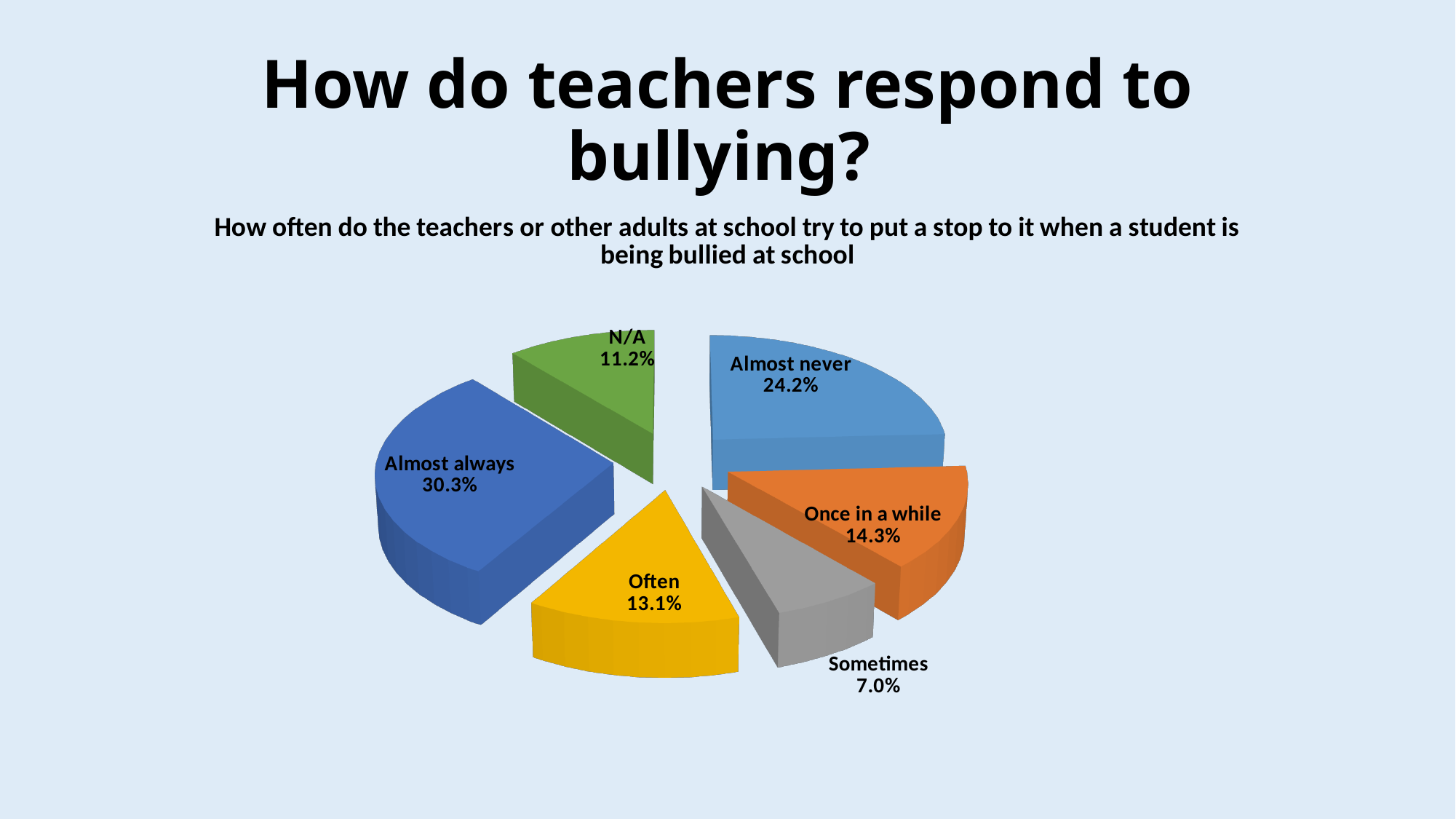
What percentage of responses were "Almost never"? 24.2% What percentage of responses were "Almost always"? 30.3% Which category has the smallest share of the pie? Sometimes Which category has the largest share of the pie? Almost always How many categories are shown in the pie chart? 6 Which is larger, the share for "Once in a while" or the share for "Often"? Once in a while What is the difference in percentage points between "Almost always" and "Almost never"? 6.1 What percentage of responses were "Sometimes"? 7.0% What colour is the "Once in a while" slice? Orange What kind of chart is shown on the slide? Pie chart What percentage of responses were "N/A"? 11.2% What is the combined percentage of "Often" and "Sometimes"? 20.1%